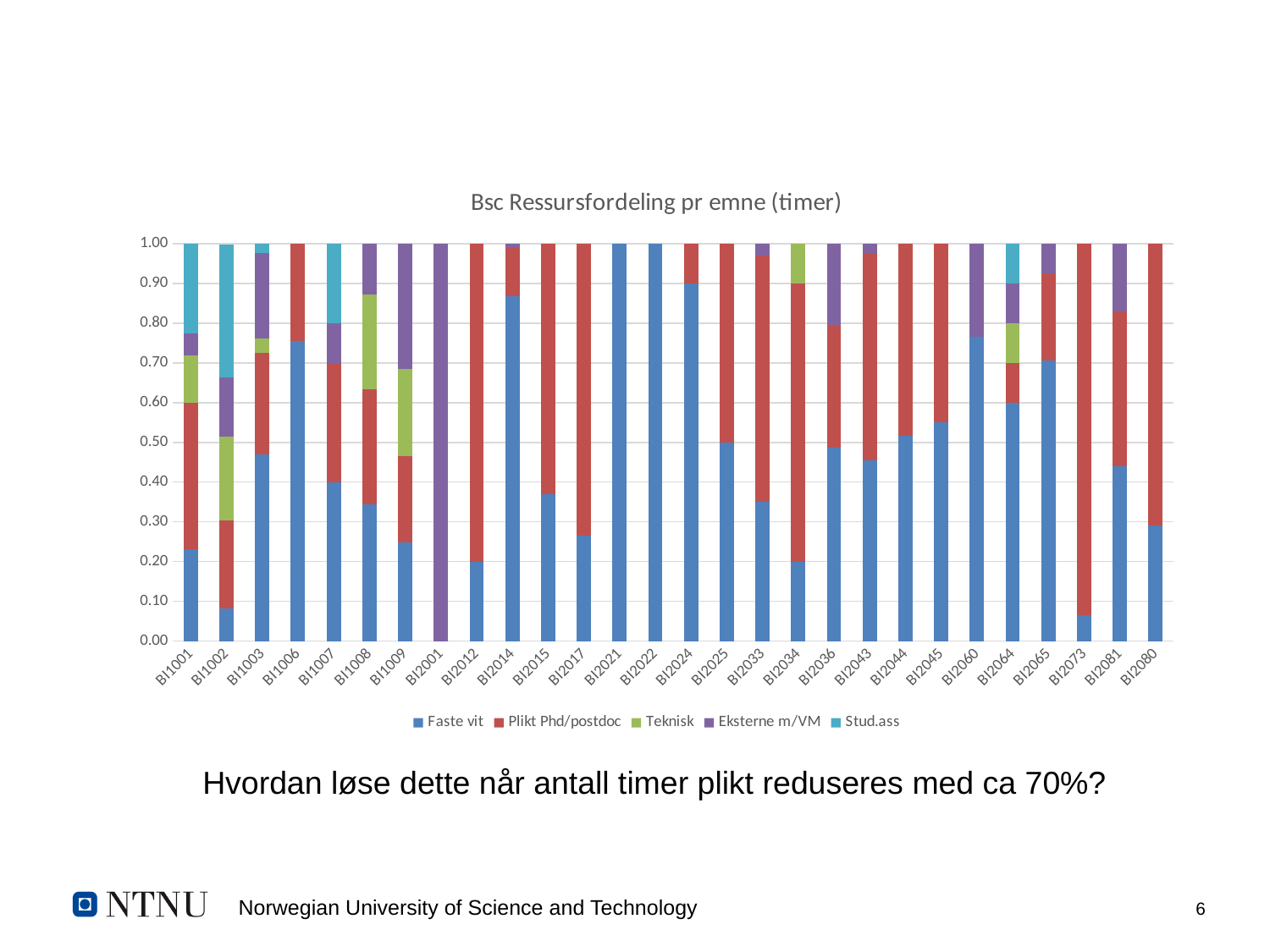
Which has the larger Faste vit share, BI1006 or BI1002? BI1006 Is the Faste vit share for BI2080 greater or less than 0.40? less What is the title of the chart? Bsc Ressursfordeling pr emne (timer) Which has the larger Faste vit share, BI2021 or BI2073? BI2021 Is the Faste vit share for BI2014 greater or less than 0.80? greater Is the Faste vit share for BI2024 greater or less than 0.80? greater How many course categories are shown on the x axis? 28 How many series does the legend list? 5 Which series is shown in blue at the bottom of each bar? Faste vit What kind of chart is shown on the slide? Stacked bar chart